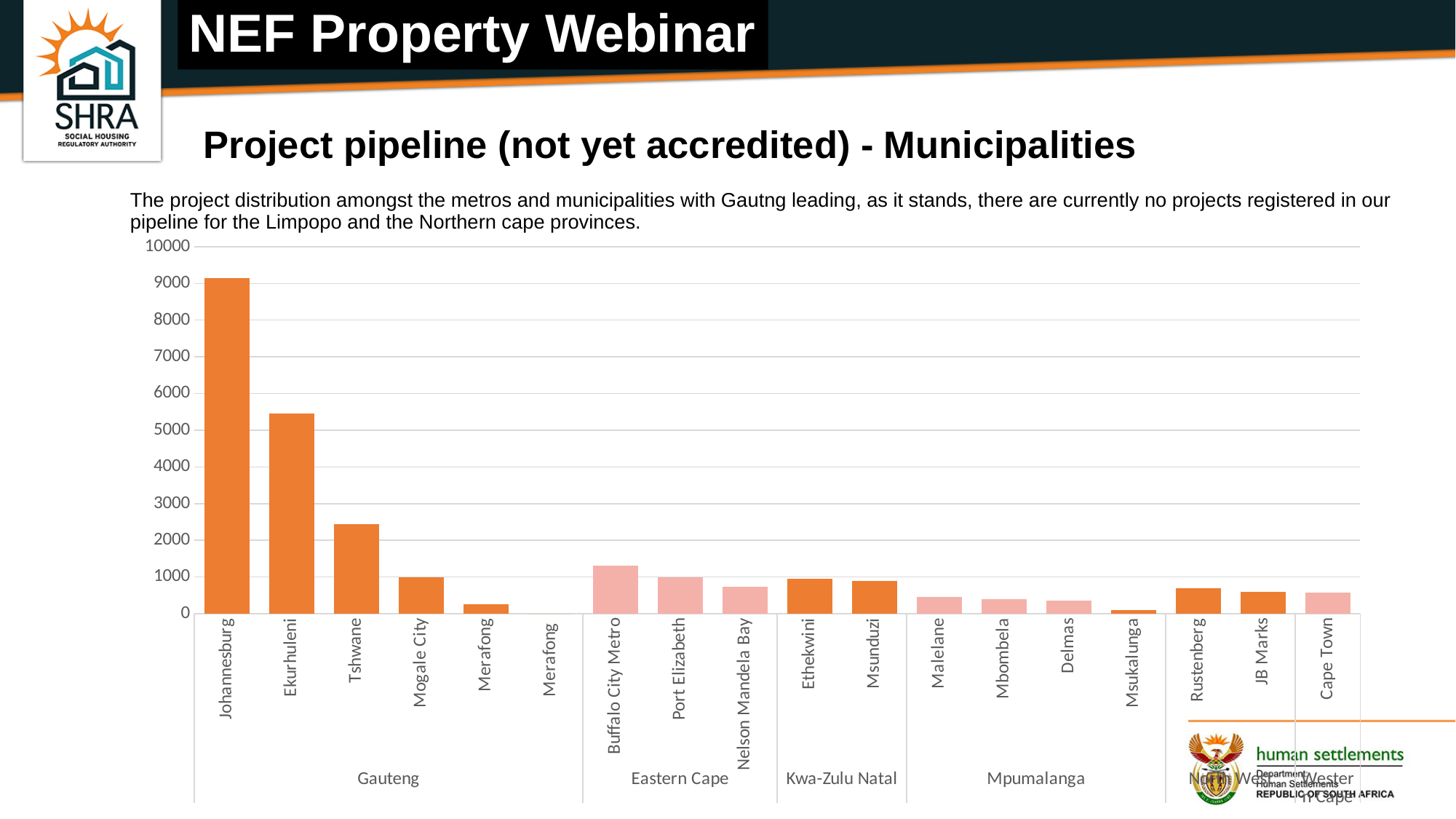
Is the value for Ekurhuleni greater or less than 5000? greater Is the value for Buffalo City Metro greater or less than 1000? greater How many municipality labels are shown along the x axis? 18 Is the value for Rustenberg greater or less than 1000? less Which has the larger value, Buffalo City Metro or Port Elizabeth? Buffalo City Metro Which municipality has the tallest bar in the chart? Johannesburg Which has the larger value, Ekurhuleni or Tshwane? Ekurhuleni What kind of chart is shown on the slide? bar chart Within the Mpumalanga group, which municipality has the lowest bar? Msukalunga Within the Gauteng group, do the values rise or fall from Johannesburg to Merafong? fall